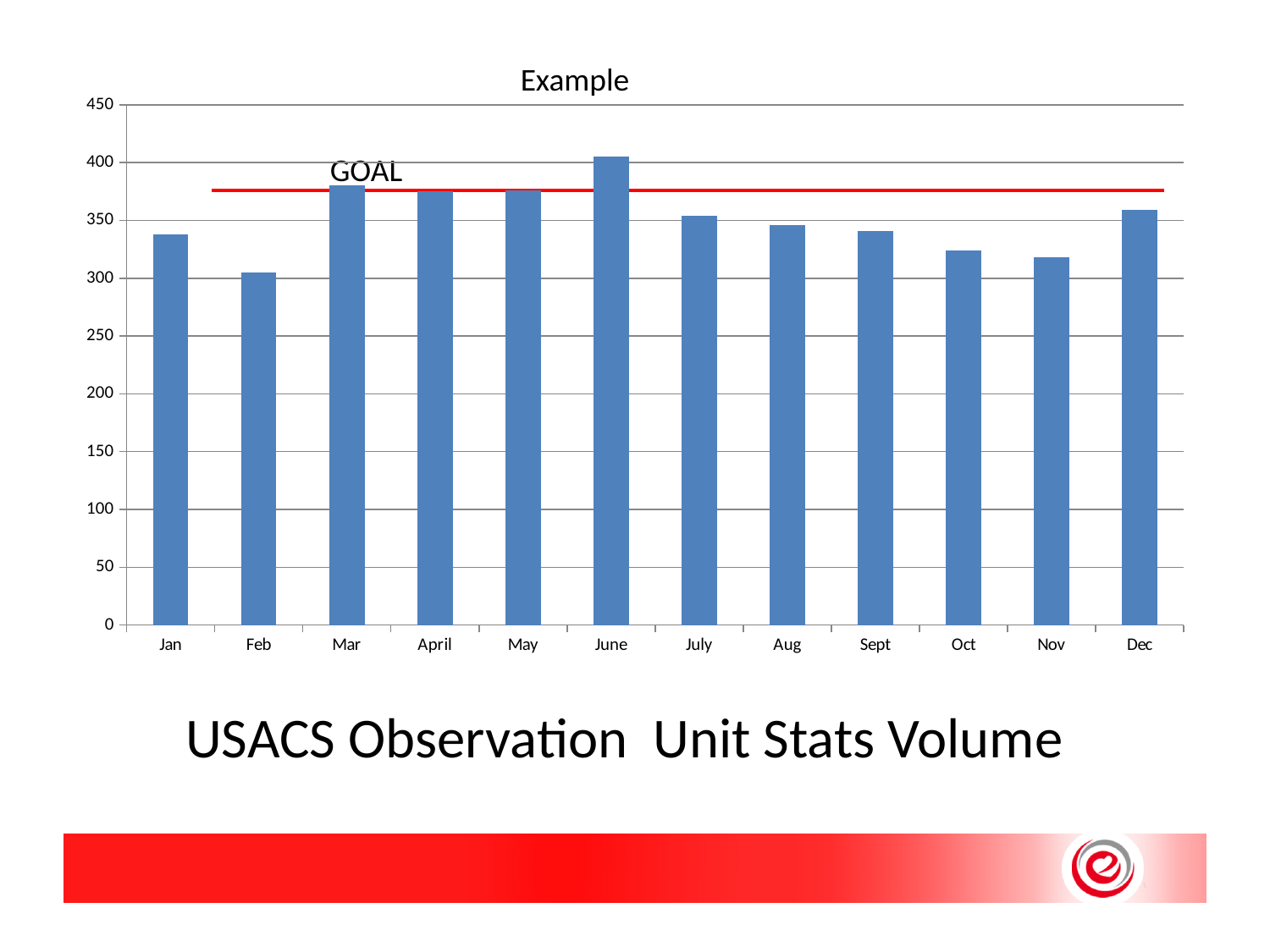
Which is larger, the value for Jan or the value for Feb? Jan Is the value for June greater or less than 400? greater What label is attached to the red horizontal line on the chart? GOAL Is the value for Nov greater or less than 300? greater What is the title shown above the chart? Example Which is larger, the value for Nov or the value for Dec? Dec Which month has the highest bar in the chart? June Is the value for Oct greater or less than 350? less What kind of chart is shown on the slide? bar chart Which month has the lowest bar in the chart? Feb How many months are plotted on the x axis of the chart? 12